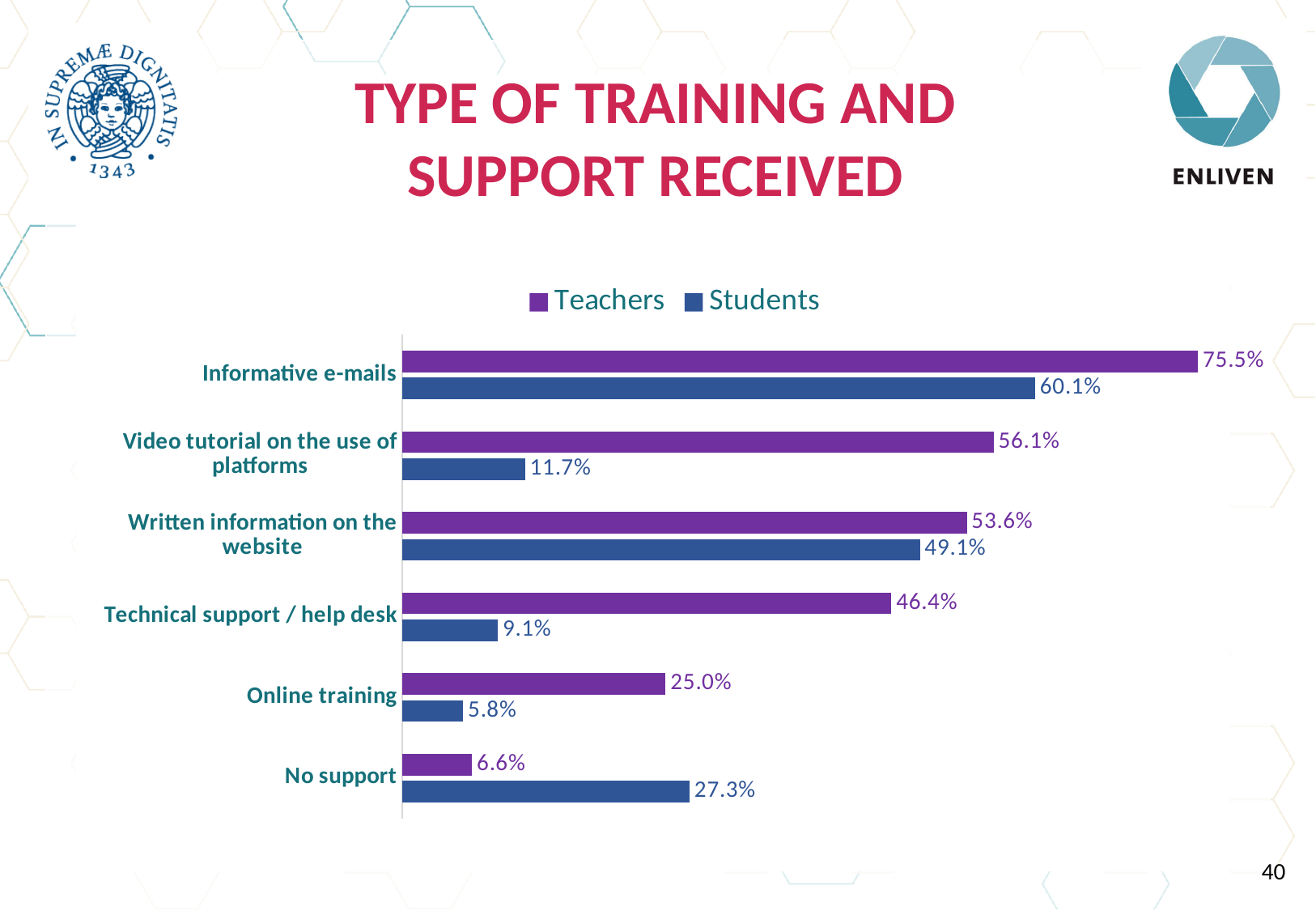
What percentage of students reported receiving no support? 27.3% What kind of chart is shown on the slide? Bar chart Which series is shown in purple? Teachers What is the difference between the teachers' and students' values for written information on the website? 4.5% Which category has the highest value for teachers? Informative e-mails What is the value for students for video tutorial on the use of platforms? 11.7% How many series does the legend list? 2 For no support, which group has the larger value, teachers or students? Students What is the difference between the teachers' and students' values for technical support / help desk? 37.3% Which category has the lowest value for students? Online training How many categories are shown on the chart? 6 What percentage of teachers received informative e-mails? 75.5%